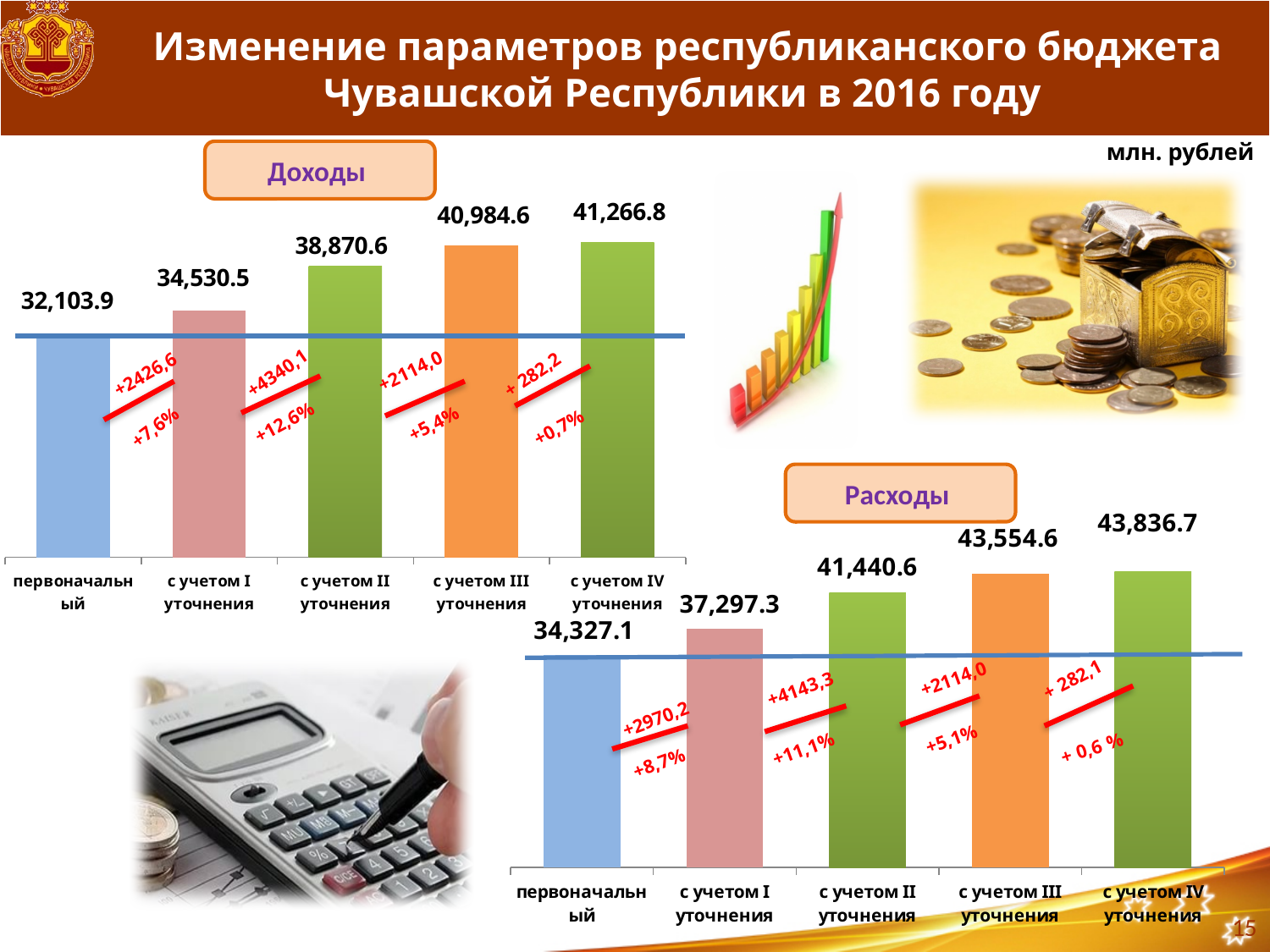
On the Расходы chart, what is the value for первоначальный? 34,327.1 On the Доходы chart, what is the difference between с учетом I уточнения and первоначальный? 2,426.6 On the Доходы chart, what is the value for с учетом II уточнения? 38,870.6 On the Доходы chart, what is the value for первоначальный? 32,103.9 On the Расходы chart, which category has the lowest value? первоначальный On the Расходы chart, what is the difference between с учетом IV уточнения and с учетом III уточнения? 282.1 What type of chart is the Доходы chart? bar chart How many categories are shown on the Расходы chart? 5 On the Расходы chart, what is the value for с учетом III уточнения? 43,554.6 On the Доходы chart, which category has the highest value? с учетом IV уточнения Which is larger: the Доходы value for с учетом IV уточнения or the Расходы value for с учетом IV уточнения? Расходы value for с учетом IV уточнения On the Доходы chart, do the values rise or fall from первоначальный to с учетом IV уточнения? rise